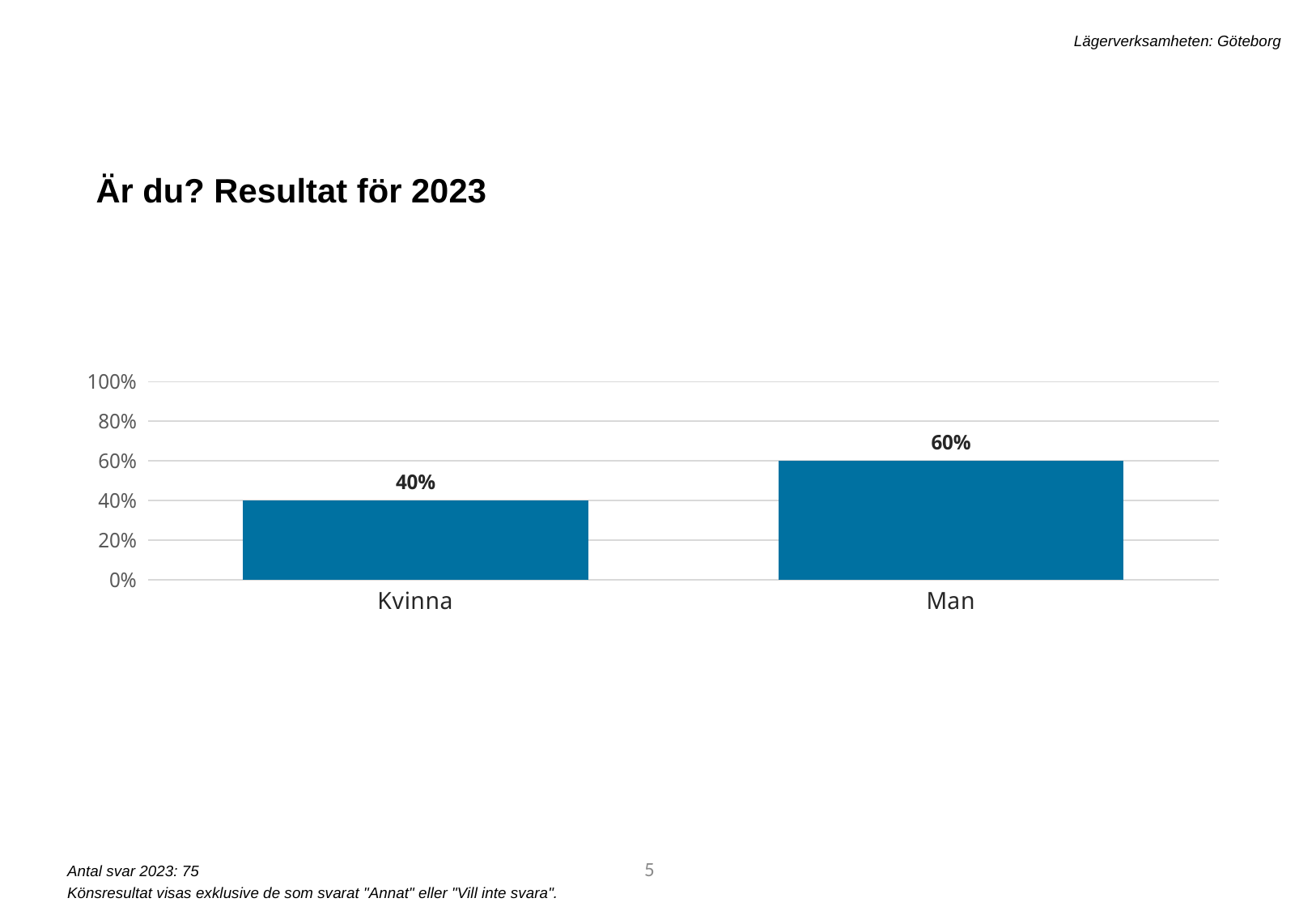
What is the title of the slide? Är du? Resultat för 2023 Which is larger, the value for Kvinna or the value for Man? Man Which category has the lowest value? Kvinna Which category has the highest value? Man Is the value for Kvinna greater or less than 20%? greater What kind of chart is shown on the slide? bar chart How many categories are shown on the x axis? 2 What is the difference between the values for Man and Kvinna? 20% What is the value for Man? 60% What is the highest value shown on the y axis? 100% What is the value for Kvinna? 40% Is the value for Man greater or less than 80%? less